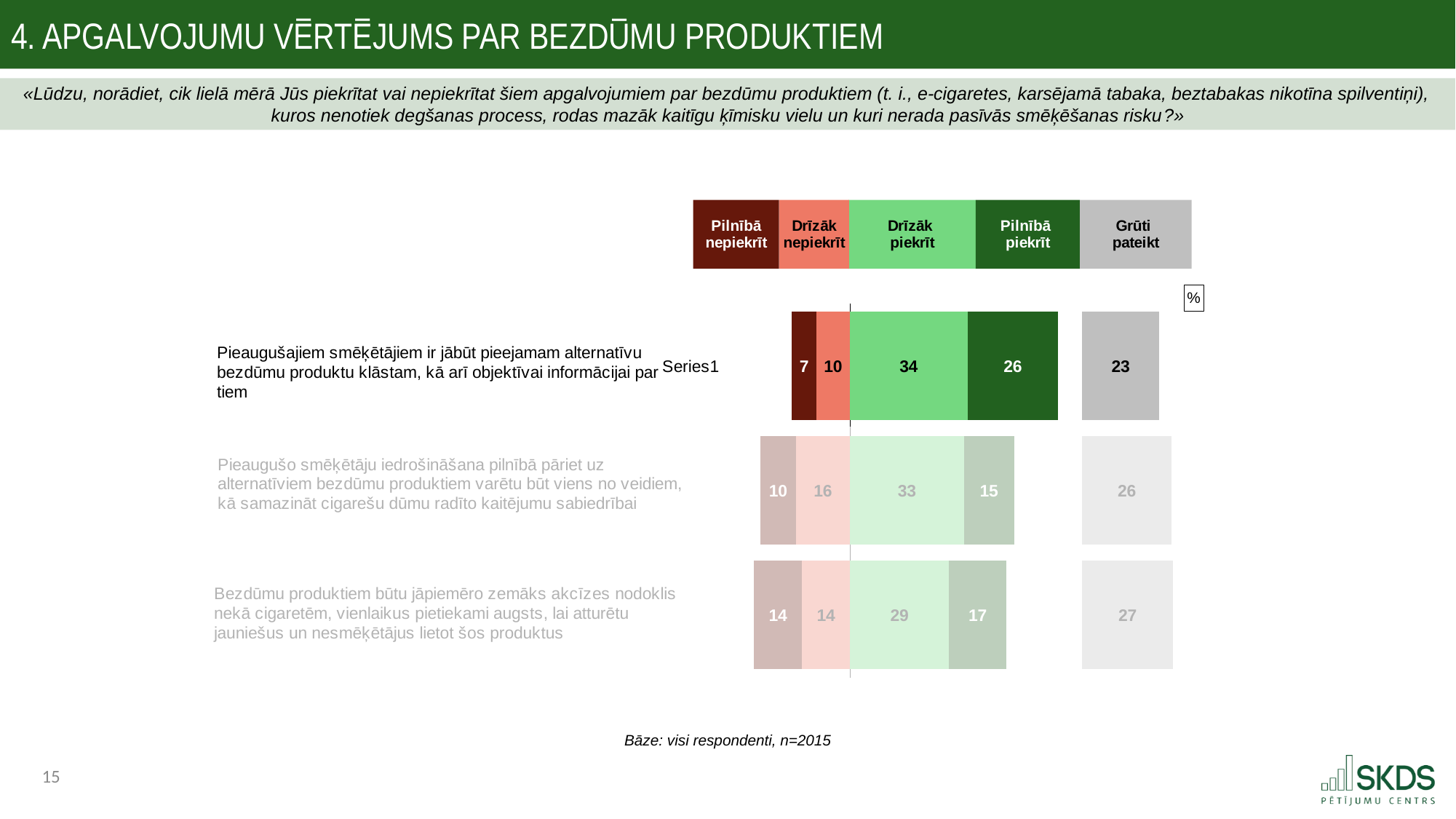
What kind of chart is shown on the slide? stacked bar chart What is the combined share of 'Drīzāk piekrīt' and 'Pilnībā piekrīt' for the top statement? 60 What is the 'Pilnībā nepiekrīt' value for the bottom statement about a lower excise tax for smoke-free products? 14 How many statements (bars) are plotted in the chart? 3 What is the 'Grūti pateikt' value for the top statement (Pieaugušajiem smēķētājiem ir jābūt pieejamam alternatīvu bezdūmu produktu klāstam...)? 23 What is the 'Pilnībā piekrīt' value for the middle statement about encouraging adult smokers to switch to alternative smoke-free products? 15 For the middle statement, which is larger: the 'Drīzāk nepiekrīt' value or the 'Pilnībā piekrīt' value? Drīzāk nepiekrīt What is the 'Drīzāk piekrīt' value for the top statement about adult smokers having access to alternative smoke-free products? 34 How many response categories does the legend list? 5 Which statement has the highest 'Pilnībā piekrīt' value? Pieaugušajiem smēķētājiem ir jābūt pieejamam alternatīvu bezdūmu produktu klāstam, kā arī objektīvai informācijai par tiem Which statement has the lowest 'Pilnībā nepiekrīt' value? Pieaugušajiem smēķētājiem ir jābūt pieejamam alternatīvu bezdūmu produktu klāstam, kā arī objektīvai informācijai par tiem What is the difference between the 'Pilnībā piekrīt' value of the top statement and that of the bottom statement? 9